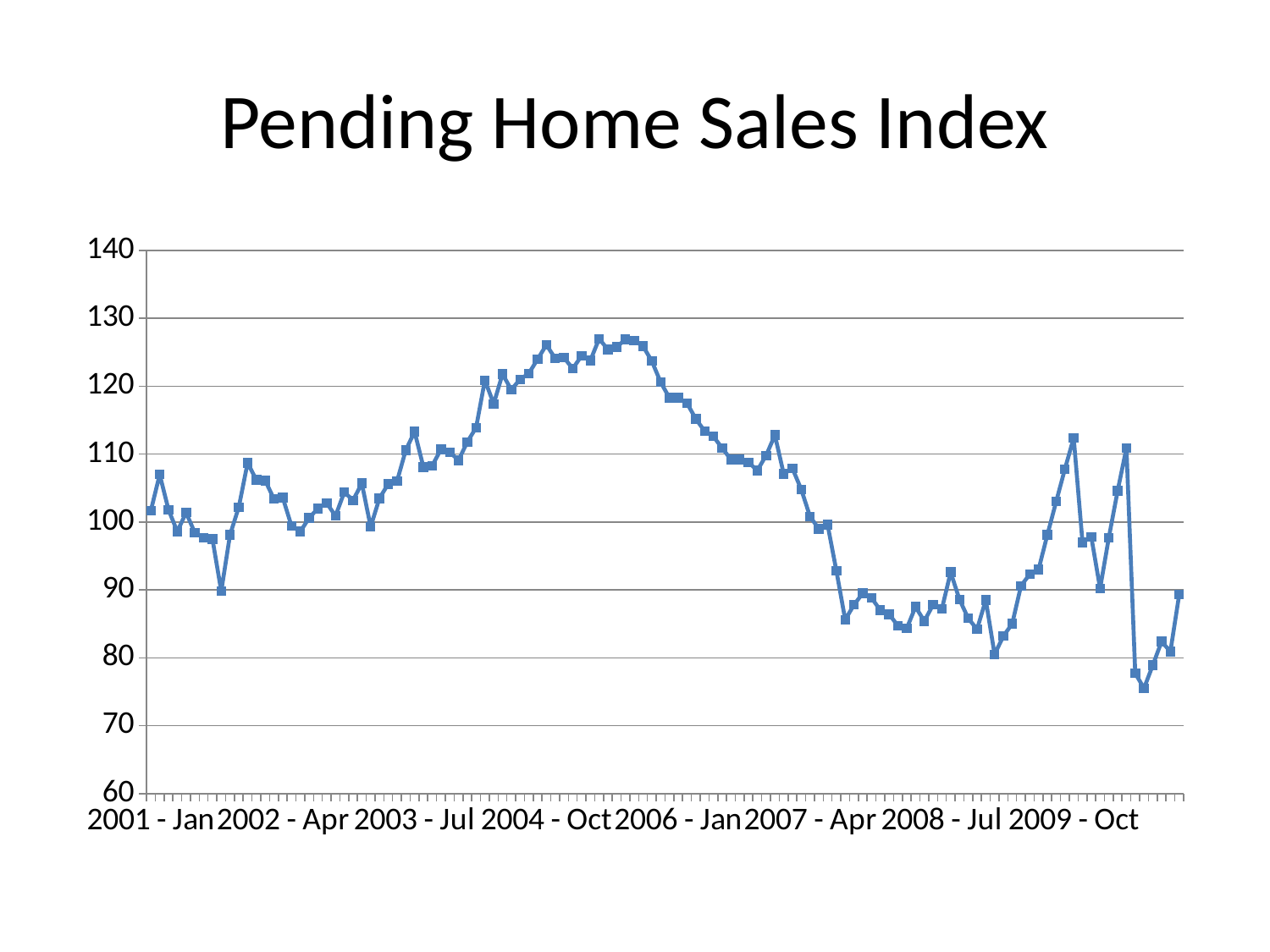
Is the value at 2006 - Jan greater or less than 110? greater Is the lowest value on the chart greater or less than 80? less Is the value at 2008 - Jul greater or less than 100? less What kind of chart is shown on the slide? line chart Which is larger, the value at 2004 - Oct or the value at 2008 - Jul? 2004 - Oct Do the values generally rise or fall between 2006 - Jan and 2008 - Jul? fall What is the title of the chart? Pending Home Sales Index What is the highest value shown on the vertical axis? 140 Do the values generally rise or fall between 2001 - Jan and 2004 - Oct? rise